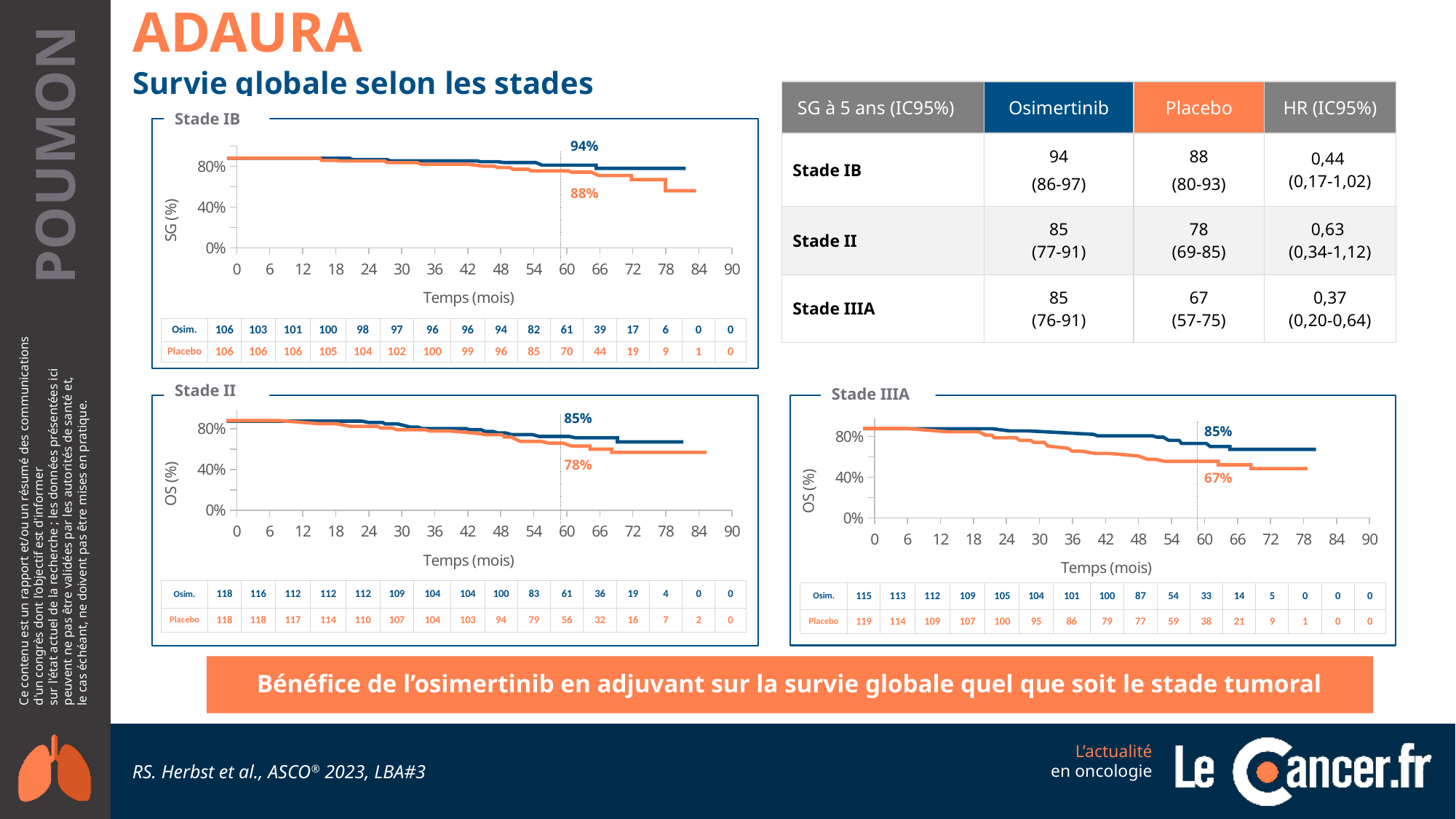
In the Stade IB chart, what overall survival value is labelled for the osimertinib (blue) curve at 60 months? 94% What kind of chart is the Stade IIIA chart? Line chart (Kaplan-Meier survival curves) In the Stade II chart, which curve is higher at 60 months, osimertinib or placebo? Osimertinib How many series (curves) are plotted in the Stade II chart? 2 In the Stade IIIA chart, is the placebo curve at 78 months greater or less than 80%? less In the Stade IB chart, what value is labelled for the placebo (orange) curve at 60 months? 88% What is the y-axis label of the Stade IB chart? SG (%) In the Stade IB chart, what is the difference between the labelled osimertinib and placebo values at 60 months? 6 percentage points In the Stade IIIA chart, what value is labelled for the osimertinib curve at 60 months? 85% In the Stade II chart, what value is labelled for the placebo curve at 60 months? 78% In the Stade IIIA chart, does the placebo curve rise or fall as time increases? Fall In the Stade IIIA chart, what is the difference between the labelled osimertinib value (85%) and the labelled placebo value (67%) at 60 months? 18 percentage points